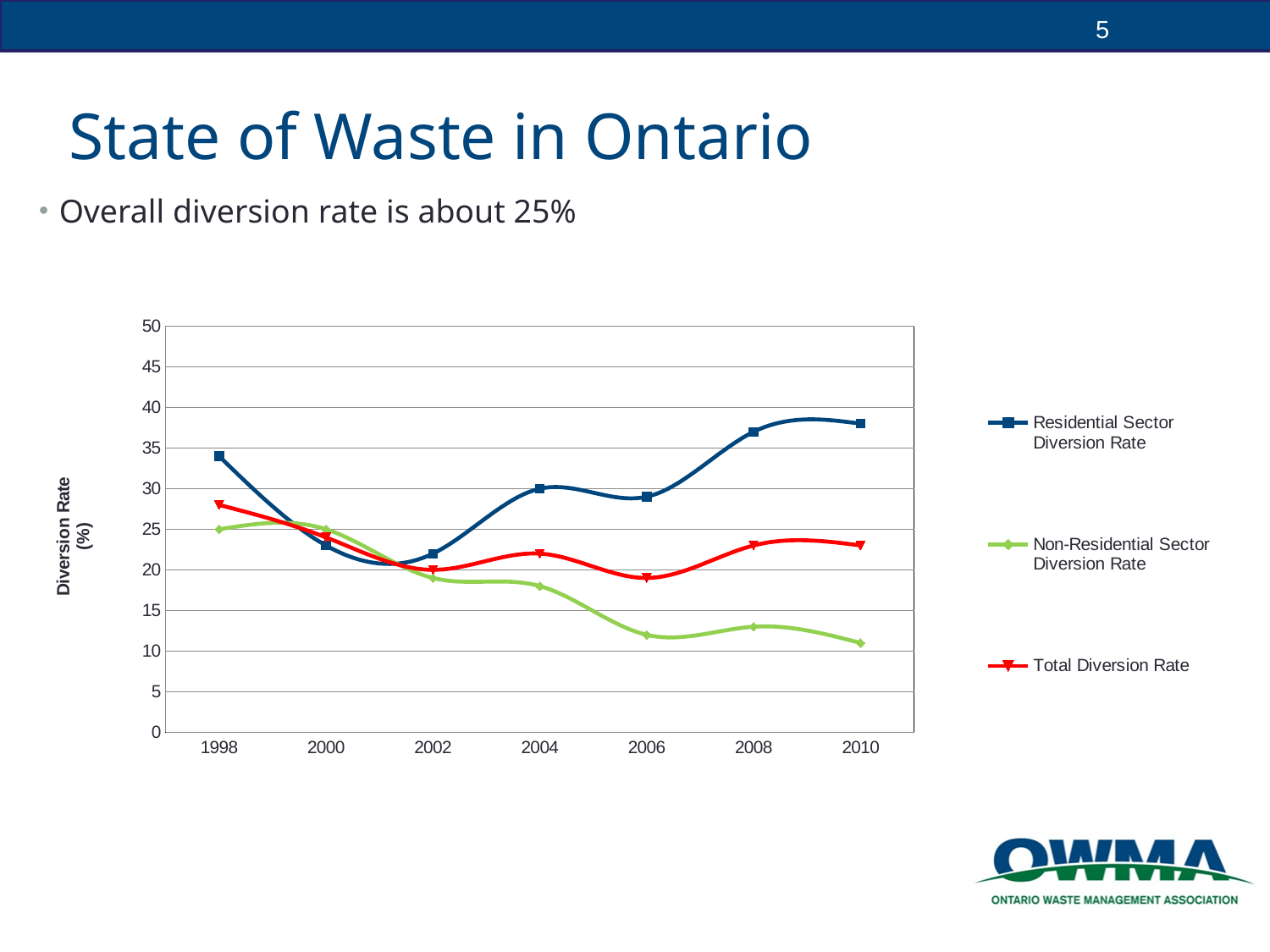
In 2010, which is larger: the Residential Sector Diversion Rate or the Non-Residential Sector Diversion Rate? Residential Sector Diversion Rate Is the Total Diversion Rate in 1998 greater or less than 25? greater What is the Residential Sector Diversion Rate in 2004? 30 Is the Residential Sector Diversion Rate in 2010 greater or less than 35? greater How many series does the chart's legend list? 3 What kind of chart is shown on the slide? line chart Is the Non-Residential Sector Diversion Rate in 2010 greater or less than 15? less What is the Total Diversion Rate in 2002? 20 How many years are plotted along the x axis of the chart? 7 Does the Non-Residential Sector Diversion Rate rise or fall overall from 1998 to 2010? fall What is the Non-Residential Sector Diversion Rate in 1998? 25 In which year is the Total Diversion Rate highest? 1998